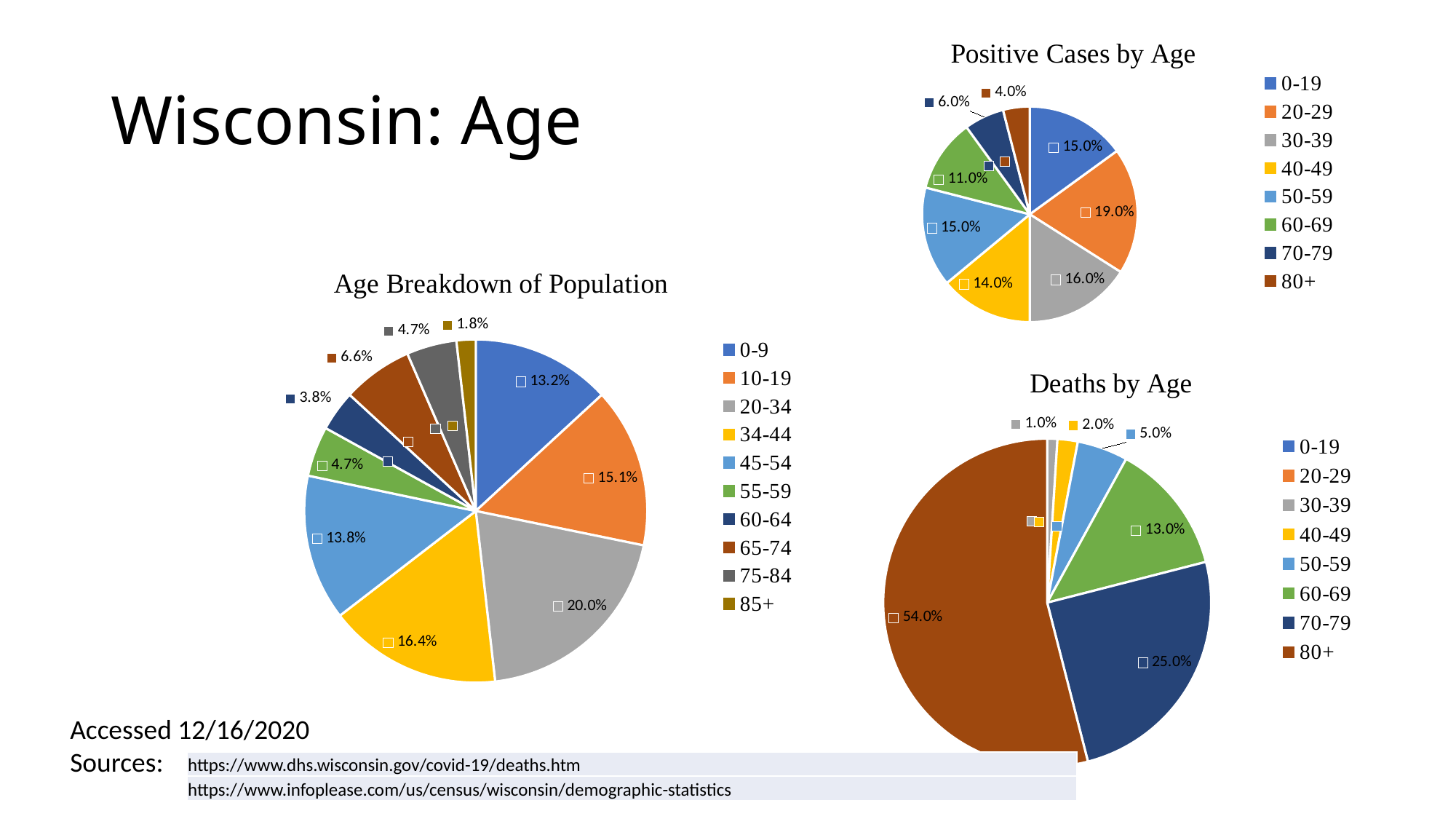
How many age groups does the legend of the Age Breakdown of Population chart list? 10 In the Positive Cases by Age chart, which is larger: the share for 60-69 or the share for 70-79? 60-69 In the Age Breakdown of Population chart, what share of the population is aged 20-34? 20.0% In the Positive Cases by Age chart, what percentage of positive cases are in the 20-29 age group? 19.0% In the Age Breakdown of Population chart, what is the difference between the 34-44 share and the 45-54 share? 2.6% How many age groups are shown in the Positive Cases by Age chart? 8 In the Deaths by Age chart, what percentage of deaths are in the 80+ age group? 54.0% In the Age Breakdown of Population chart, which age group has the smallest share? 85+ In the Deaths by Age chart, what is the difference between the 70-79 share and the 60-69 share? 12.0% In the Deaths by Age chart, what colour is the 80+ slice? Brown What type of chart is the Deaths by Age chart? Pie chart In the Positive Cases by Age chart, which age group has the largest share of positive cases? 20-29